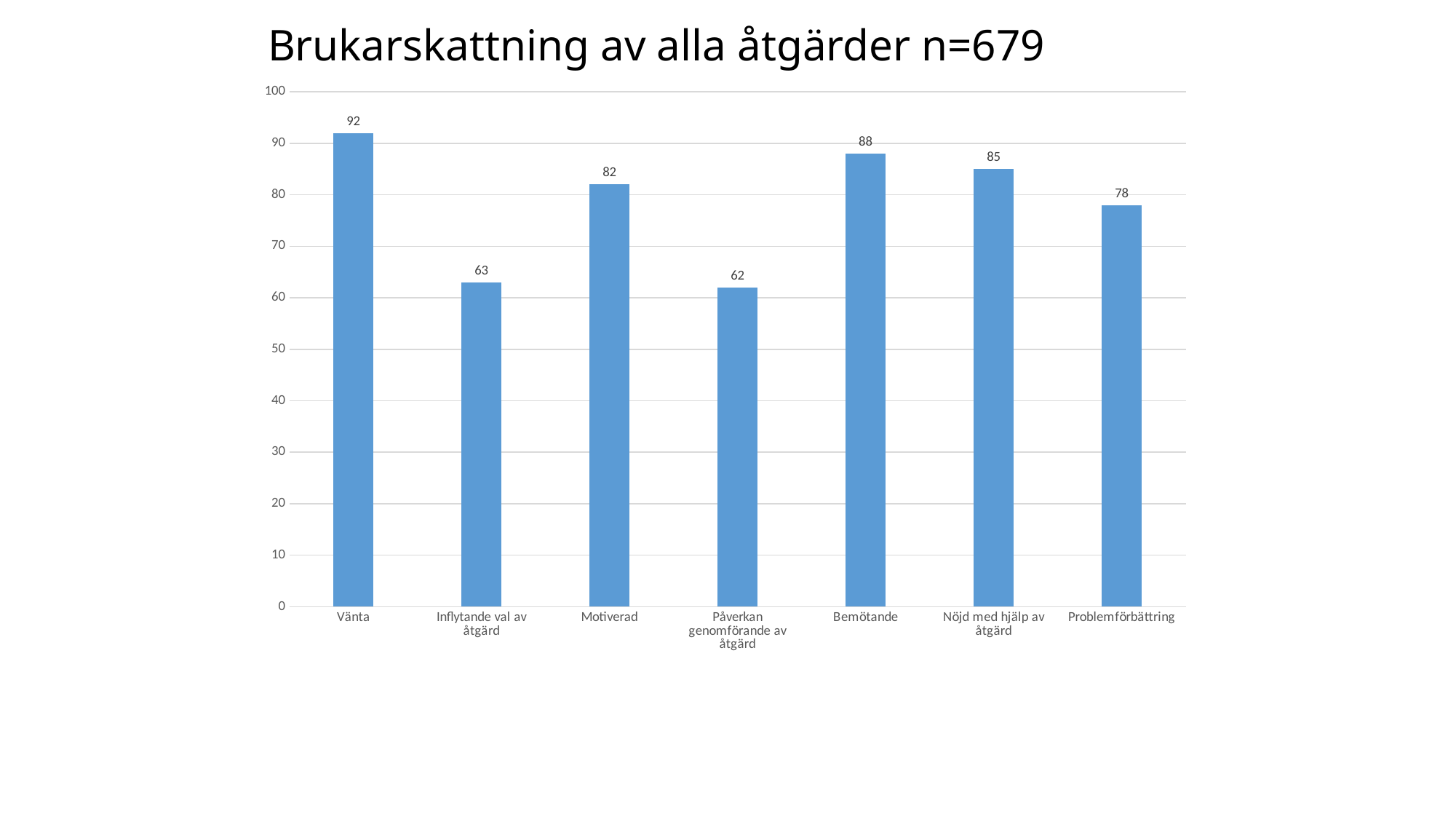
How many categories are shown on the x axis? 7 Which is larger, the value for Motiverad or the value for Problemförbättring? Motiverad Which category has the highest value? Vänta What is the title of the chart? Brukarskattning av alla åtgärder n=679 What is the difference between the values for Vänta and Inflytande val av åtgärd? 29 What is the difference between the values for Bemötande and Nöjd med hjälp av åtgärd? 3 What is the value for Vänta? 92 What is the value for Problemförbättring? 78 What is the value for Bemötande? 88 Is the value for Nöjd med hjälp av åtgärd greater or less than 80? greater What kind of chart is shown on the slide? bar chart Which category has the lowest value? Påverkan genomförande av åtgärd